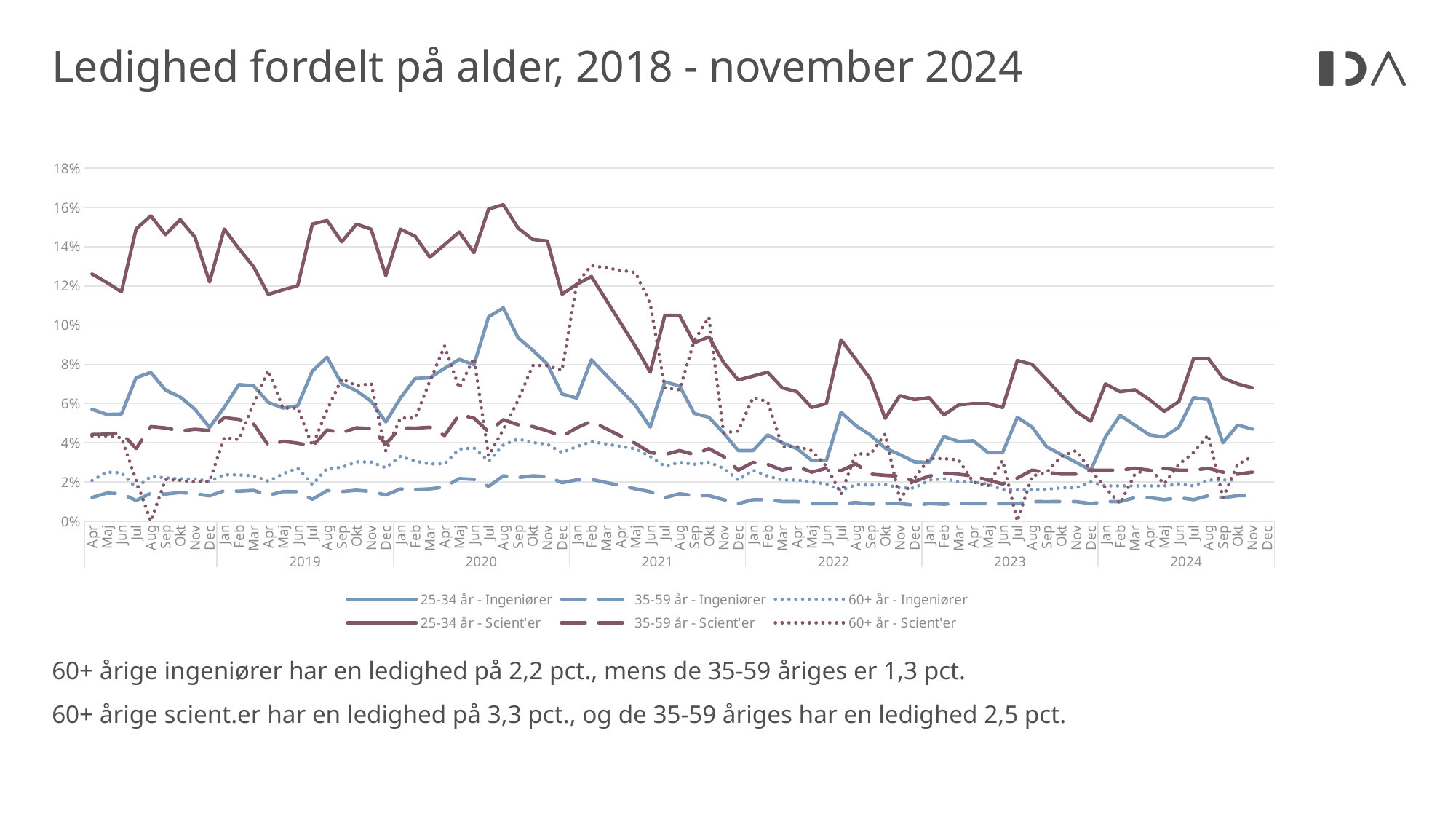
What kind of chart is shown on the slide? line chart Does the 25-34 år - Scient'er series overall rise or fall from 2018 to 2024? fall According to the slide, what is the unemployment rate for 35-59 årige ingeniører? 1,3 pct. What is the title of the chart? Ledighed fordelt på alder, 2018 - november 2024 How much higher is the unemployment rate for 60+ årige scient.er than for 60+ årige ingeniører, according to the slide text? 1,1 pct. Which series has the highest value at the start of the chart in Apr 2018? 25-34 år - Scient'er Which has the higher unemployment rate according to the slide text: 60+ årige ingeniører or 35-59 årige ingeniører? 60+ årige ingeniører According to the slide, what is the unemployment rate for 60+ årige ingeniører? 2,2 pct. Is the value for 25-34 år - Scient'er in Aug 2020 greater or less than 14%? greater According to the slide, what is the unemployment rate for 60+ årige scient.er? 3,3 pct. According to the slide, what is the unemployment rate for 35-59 årige scient.er? 2,5 pct. How many series does the legend list? 6